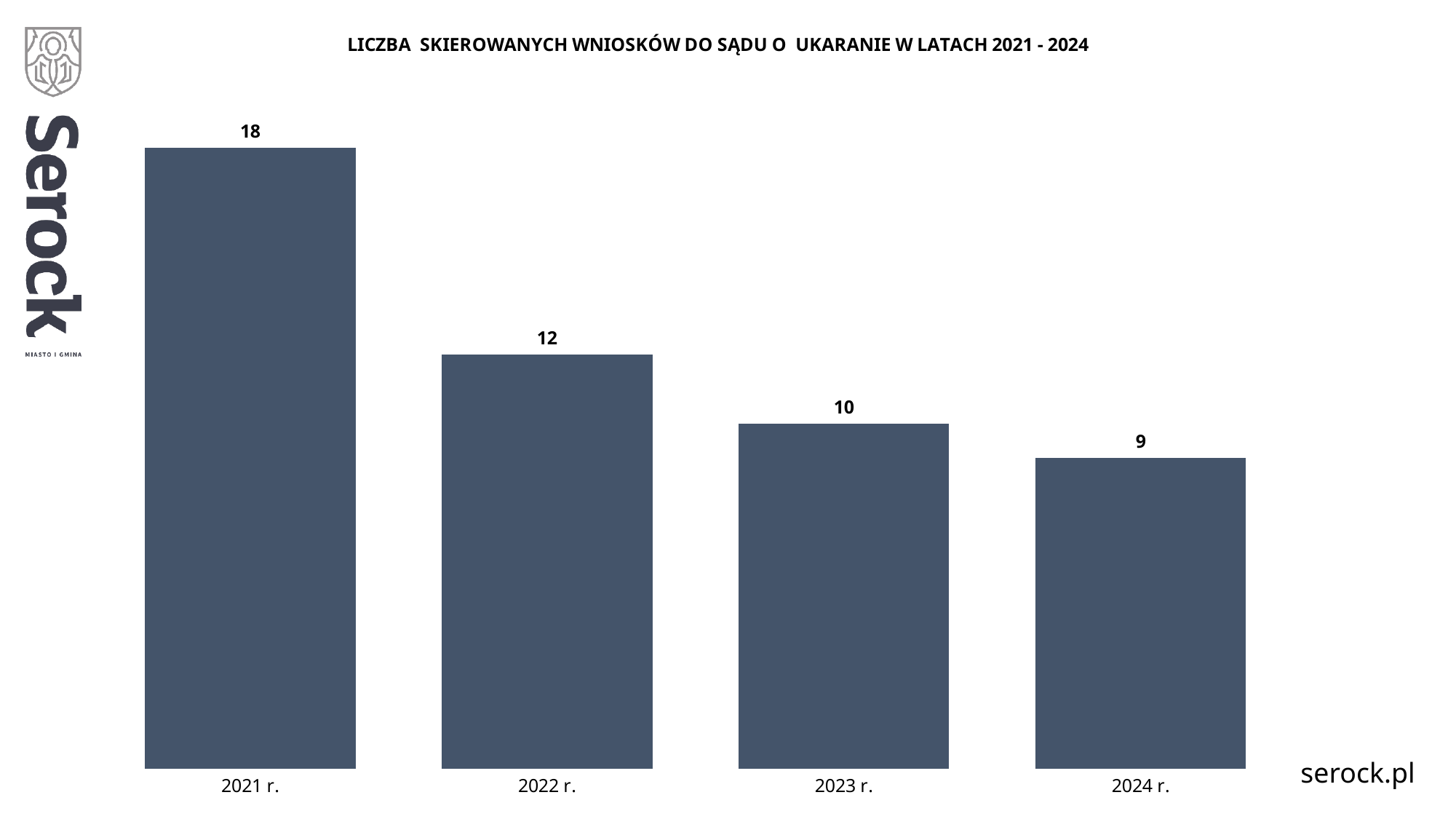
Which year has the lowest value? 2024 r. Do the values rise or fall from 2021 r. to 2024 r.? fall Which year has the highest value? 2021 r. Which is larger, the value for 2022 r. or the value for 2023 r.? 2022 r. What is the value for 2022 r.? 12 What is the difference between the values for 2022 r. and 2023 r.? 2 What is the value for 2021 r.? 18 How many years are shown on the chart? 4 What kind of chart is shown on the slide? bar chart What is the value for 2024 r.? 9 What is the value for 2023 r.? 10 What is the difference between the values for 2021 r. and 2024 r.? 9